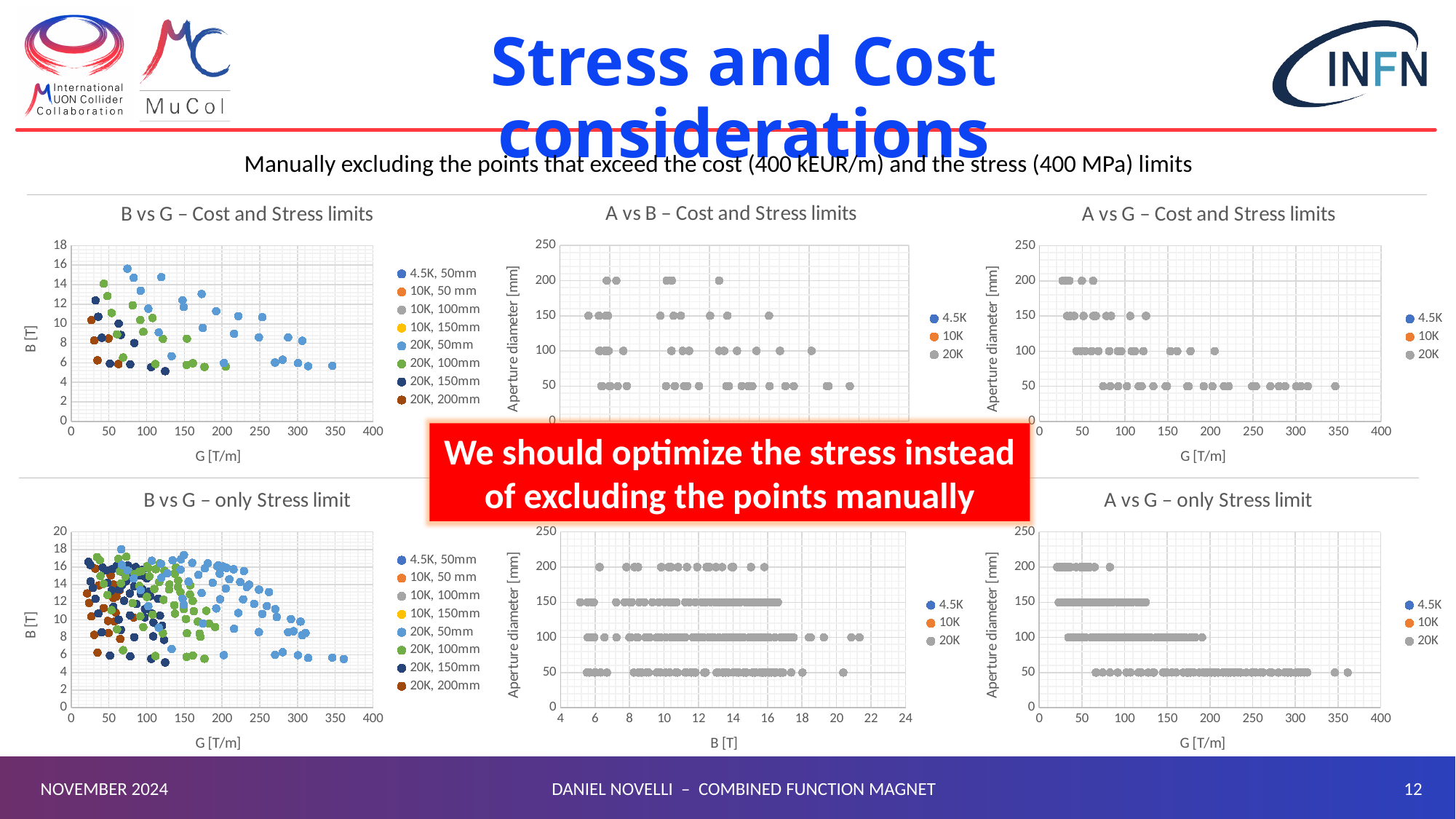
In the "B vs G – Cost and Stress limits" chart, is the highest plotted B value greater or less than 14? greater How many series does the legend of the "B vs G – only Stress limit" chart list? 8 In the "A vs G – only Stress limit" chart, is the largest G value of the 200 mm aperture points greater or less than 150? less How many charts are shown on the slide? 6 In the "A vs G – only Stress limit" chart, how many distinct aperture diameter levels have plotted points? 4 What kind of chart is the "B vs G – Cost and Stress limits" chart? Scatter chart What is the x-axis label of the "B vs G – only Stress limit" chart? G [T/m] In the "A vs G – Cost and Stress limits" chart, is the largest G value of the 50 mm aperture points greater or less than 300? greater In the "A vs G – only Stress limit" chart, what is the largest aperture diameter value at which points are plotted? 200 What is the y-axis label of the "A vs G – Cost and Stress limits" chart? Aperture diameter [mm] How many series does the legend of the "A vs G – Cost and Stress limits" chart list? 3